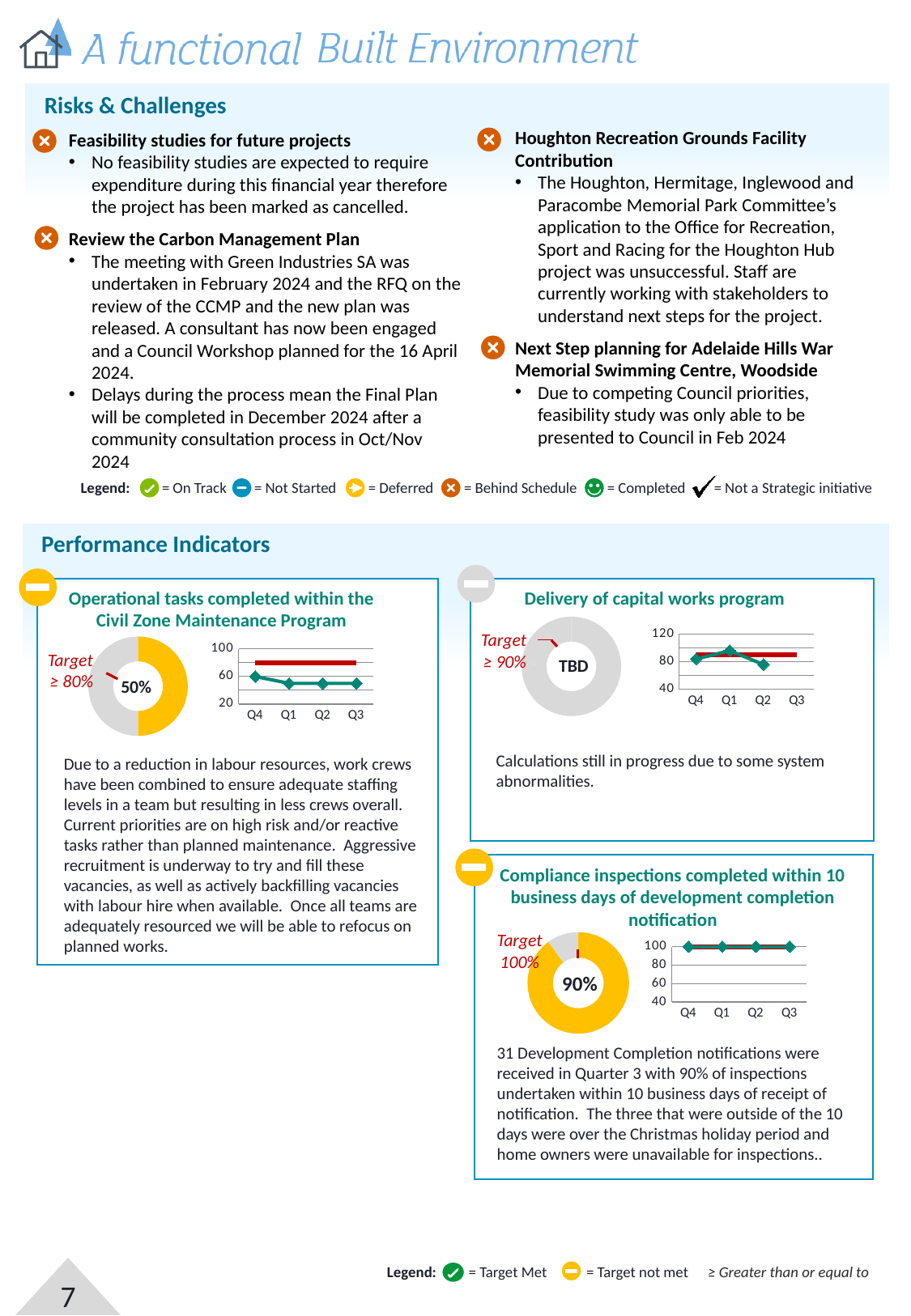
On the 'Delivery of capital works program' chart, what is the target shown? ≥ 90% On the line chart in the 'Delivery of capital works program' panel, is the value for Q2 greater or less than 80? less On the line chart in the 'Operational tasks completed within the Civil Zone Maintenance Program' panel, is the value for Q2 greater or less than 60? less What kind of chart is the small quarterly chart in the 'Delivery of capital works program' panel? Line chart On the 'Operational tasks completed within the Civil Zone Maintenance Program' chart, what is the target shown? ≥ 80% On the 'Compliance inspections completed within 10 business days of development completion notification' chart, what percentage is shown in the centre of the donut? 90% On the 'Compliance inspections completed within 10 business days of development completion notification' chart, what is the target shown? 100% On the 'Operational tasks completed within the Civil Zone Maintenance Program' chart, what percentage is shown in the centre of the donut? 50% On the line chart in the 'Operational tasks completed within the Civil Zone Maintenance Program' panel, does the value rise or fall from Q4 to Q1? fall On the 'Delivery of capital works program' chart, what value is shown in the centre of the donut? TBD On the line chart in the 'Delivery of capital works program' panel, is the value for Q1 greater or less than 80? greater How many quarters are plotted on the x axis of the line chart in the 'Operational tasks completed within the Civil Zone Maintenance Program' panel? 4